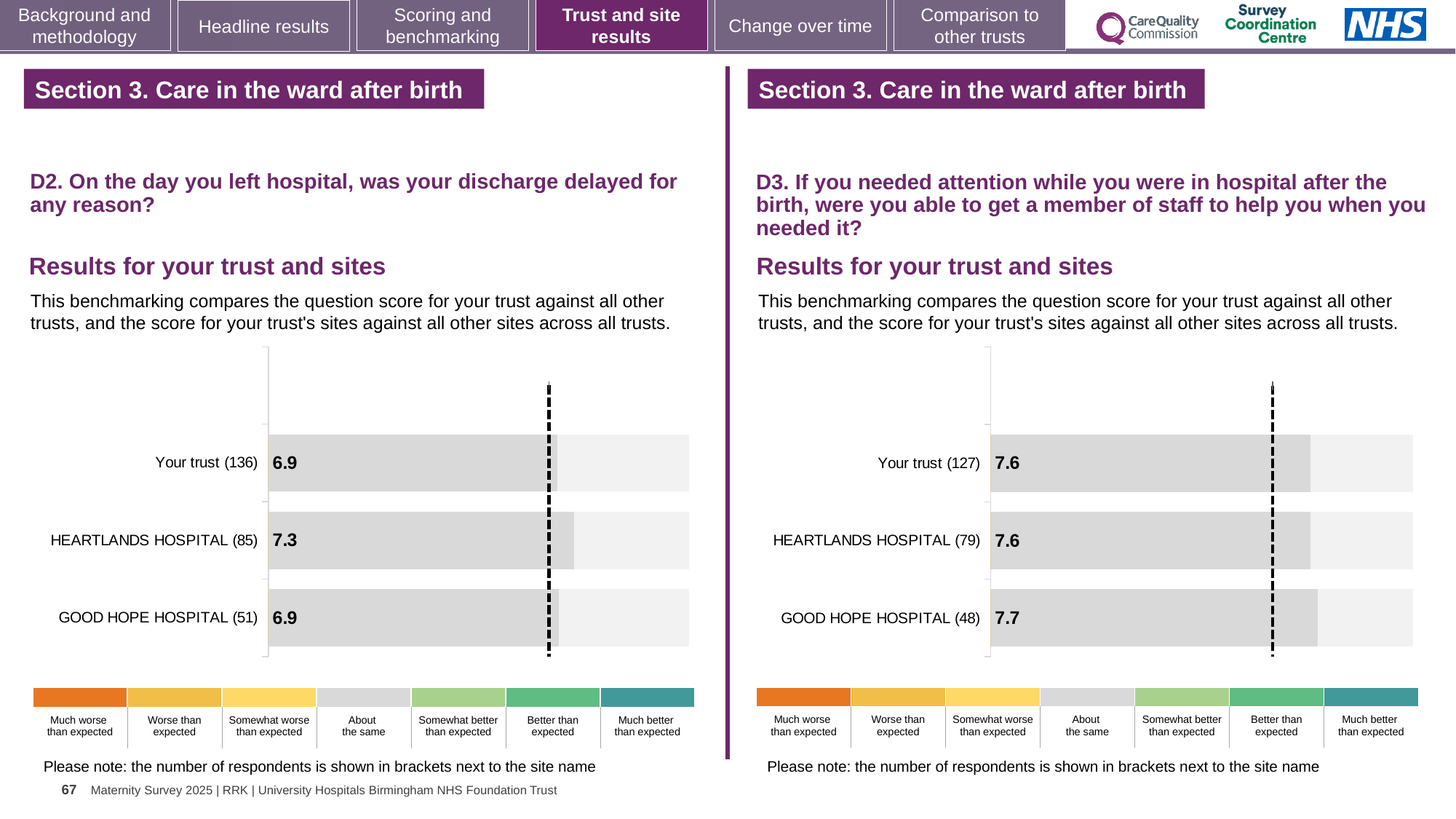
In the left chart (D2, discharge delayed), what is the difference between the HEARTLANDS HOSPITAL score and the Your trust score? 0.4 In the left chart (D2, discharge delayed), how many respondents are shown in brackets for GOOD HOPE HOSPITAL? 51 In the left chart (D2, discharge delayed), which site or trust has the highest score? HEARTLANDS HOSPITAL In the left chart (D2, discharge delayed), what is the score for HEARTLANDS HOSPITAL? 7.3 In the right chart (D3, able to get a member of staff to help), what is the score for GOOD HOPE HOSPITAL? 7.7 What kind of chart is used in the right chart (D3, able to get a member of staff to help)? Bar chart In the right chart (D3, able to get a member of staff to help), which site or trust has the highest score? GOOD HOPE HOSPITAL In the right chart (D3, able to get a member of staff to help), how many respondents are shown in brackets for HEARTLANDS HOSPITAL? 79 In the left chart (D2, discharge delayed), what is the score for GOOD HOPE HOSPITAL? 6.9 In the right chart (D3, able to get a member of staff to help), what is the score for Your trust? 7.6 In the left chart (D2, discharge delayed), what is the score for Your trust? 6.9 How many bars are plotted in the left chart (D2, discharge delayed)? 3